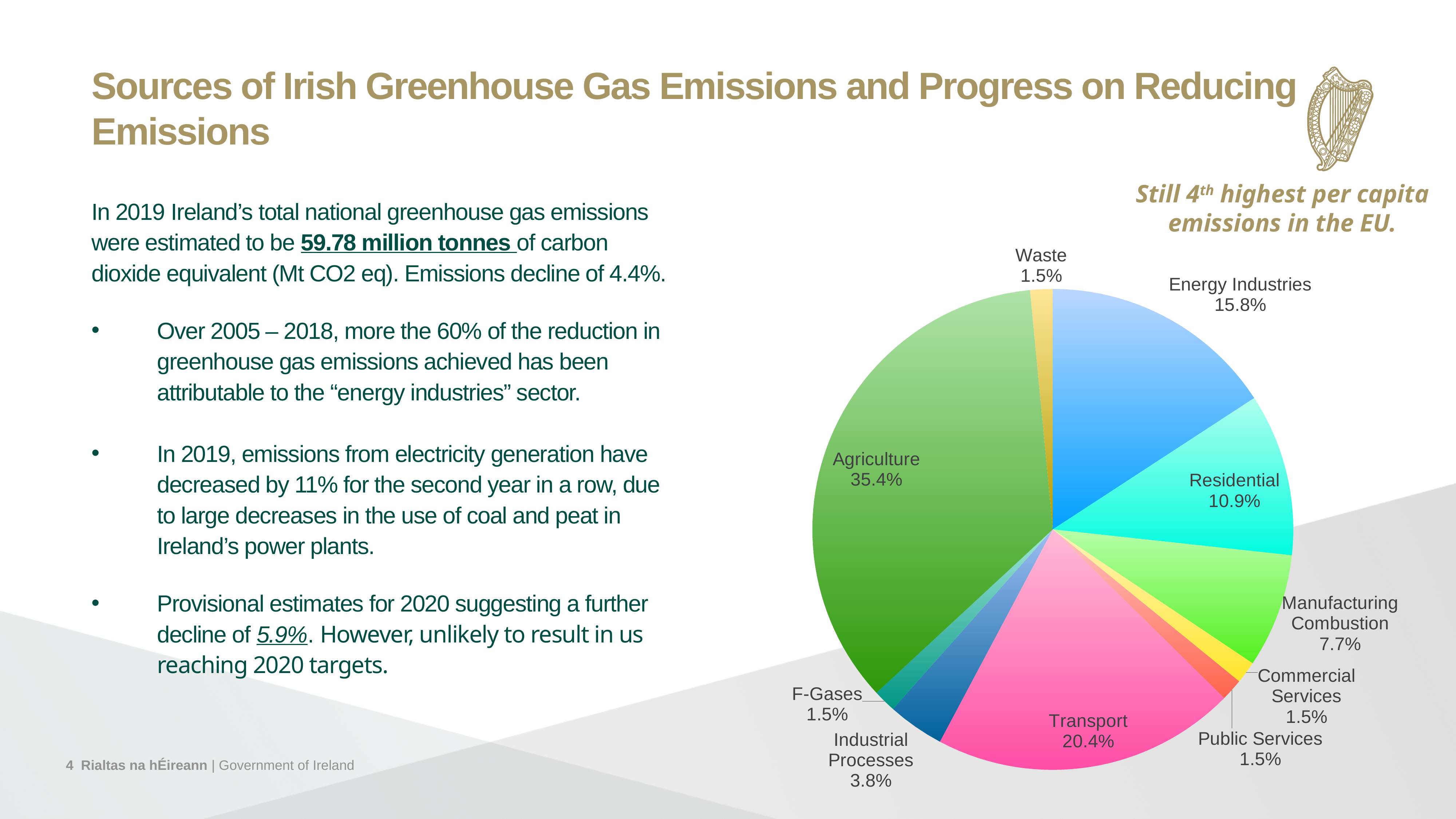
Which category has the largest slice in the pie chart? Agriculture Which is larger in the pie chart, Residential or Manufacturing Combustion? Residential What is the difference between the Agriculture and Transport shares in the pie chart? 15.0% What is the value shown for Transport in the pie chart? 20.4% How many categories are shown in the pie chart? 10 What is the value shown for Energy Industries in the pie chart? 15.8% What kind of chart is shown on the slide? pie chart What is the difference between the Energy Industries and Residential shares in the pie chart? 4.9% What colour is the Transport slice in the pie chart? pink What is the value shown for Manufacturing Combustion in the pie chart? 7.7% What share of emissions does Agriculture account for in the pie chart? 35.4% What is the value shown for Industrial Processes in the pie chart? 3.8%